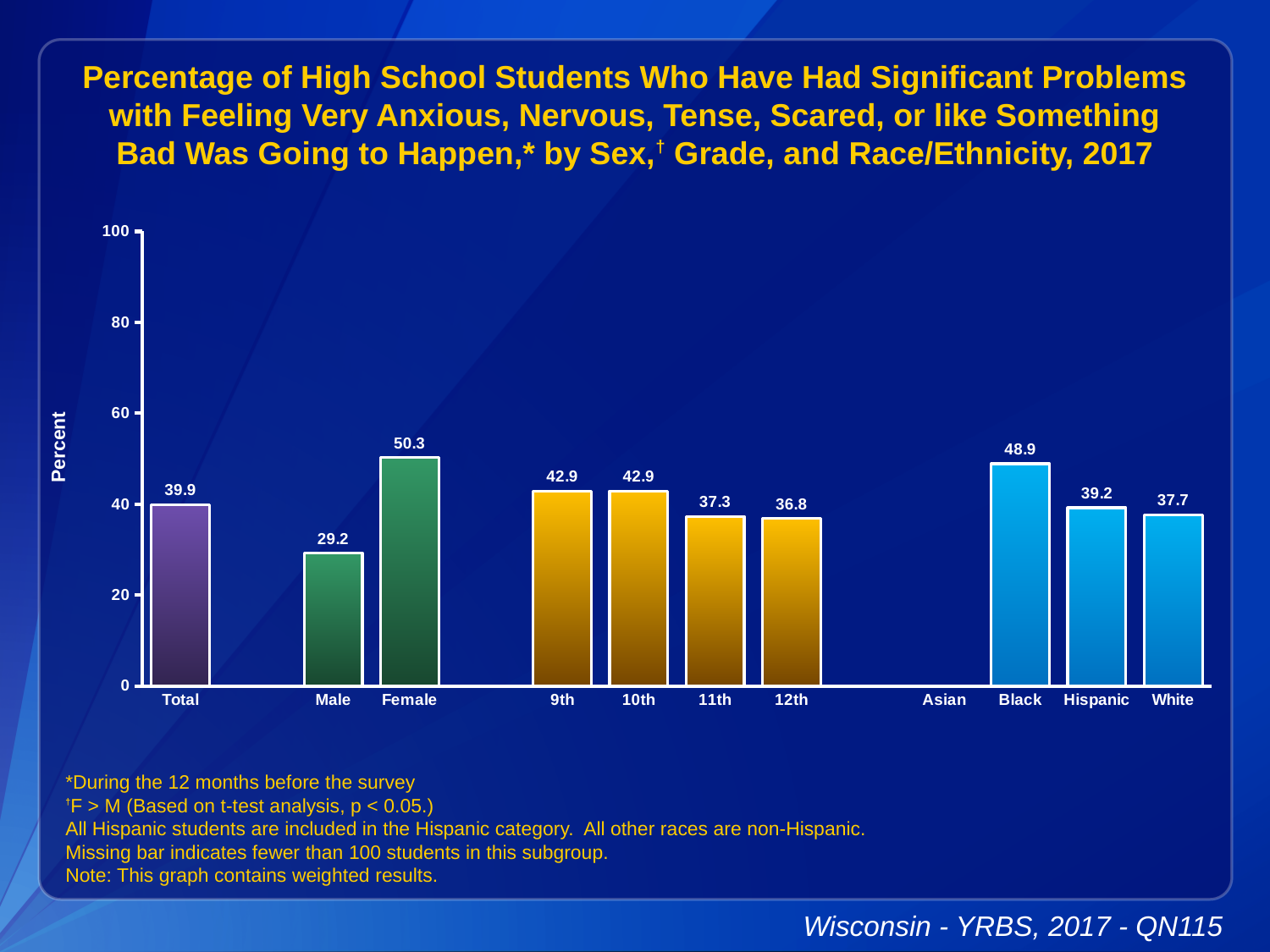
What is the value for Black students? 48.9 How many categories have a bar plotted? 10 What is the value for Female? 50.3 Which category with a bar has the lowest value? Male What is the value for 12th grade? 36.8 Is the value for Total greater or less than 40? less Which category has no bar shown? Asian What is the difference between the Female and Male values? 21.1 Which category has the highest value? Female What kind of chart is shown? bar chart What is the value for Male? 29.2 Which is larger, the value for Hispanic or the value for White? Hispanic